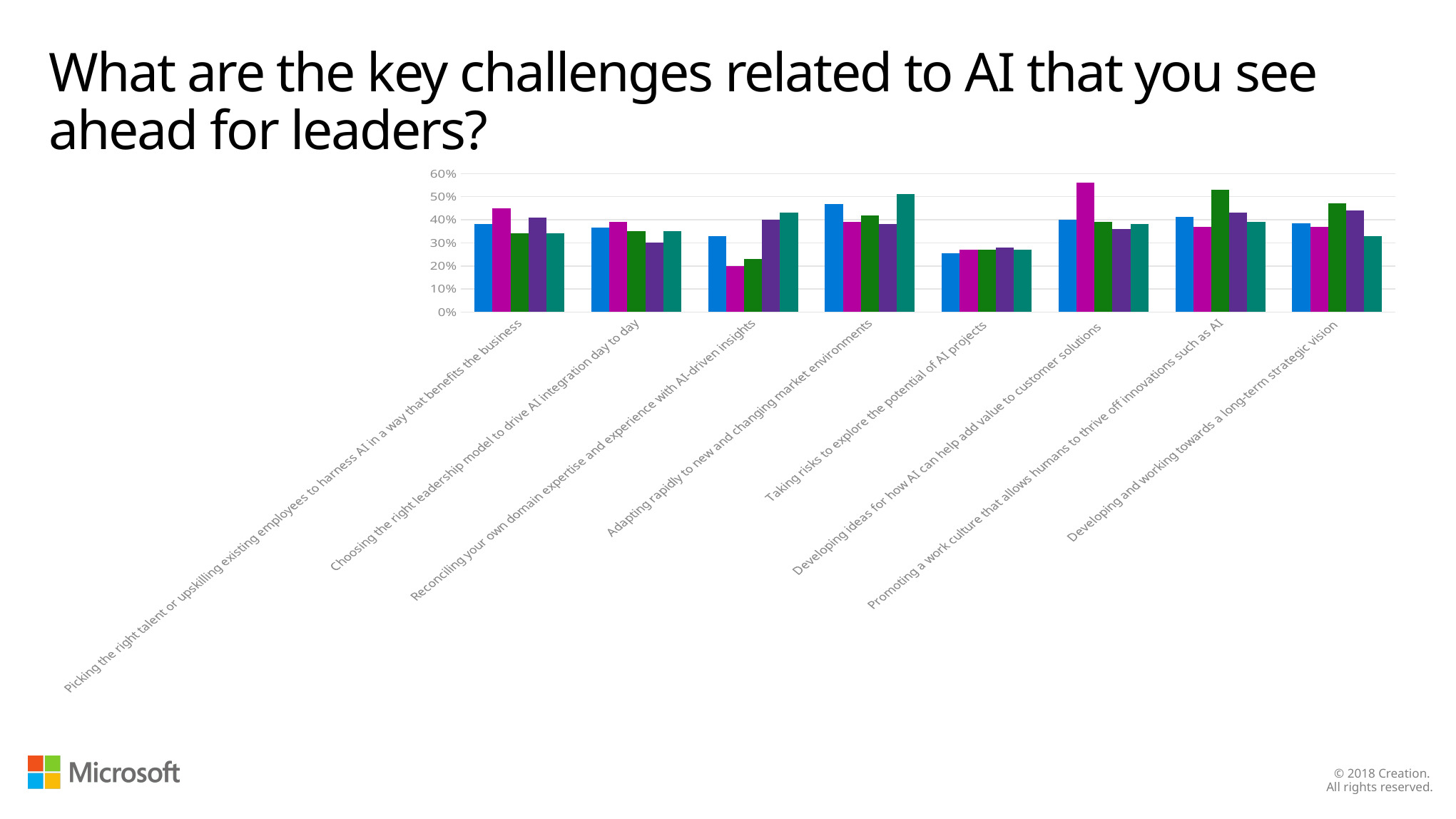
Is the magenta bar for "Reconciling your own domain expertise and experience with AI-driven insights" greater or less than 30%? less Is the teal bar for "Adapting rapidly to new and changing market environments" greater or less than 40%? greater What kind of chart is shown on the slide? bar chart How many challenge categories are shown along the x axis? 8 Is the blue bar for "Taking risks to explore the potential of AI projects" greater or less than 30%? less Which challenge category contains the tallest bar in the chart? Developing ideas for how AI can help add value to customer solutions How many bars are plotted for each challenge category? 5 For "Promoting a work culture that allows humans to thrive off innovations such as AI", which is larger, the green bar or the magenta bar? green bar Which challenge category contains the shortest bar in the chart? Reconciling your own domain expertise and experience with AI-driven insights For "Reconciling your own domain expertise and experience with AI-driven insights", which is larger, the teal bar or the blue bar? teal bar